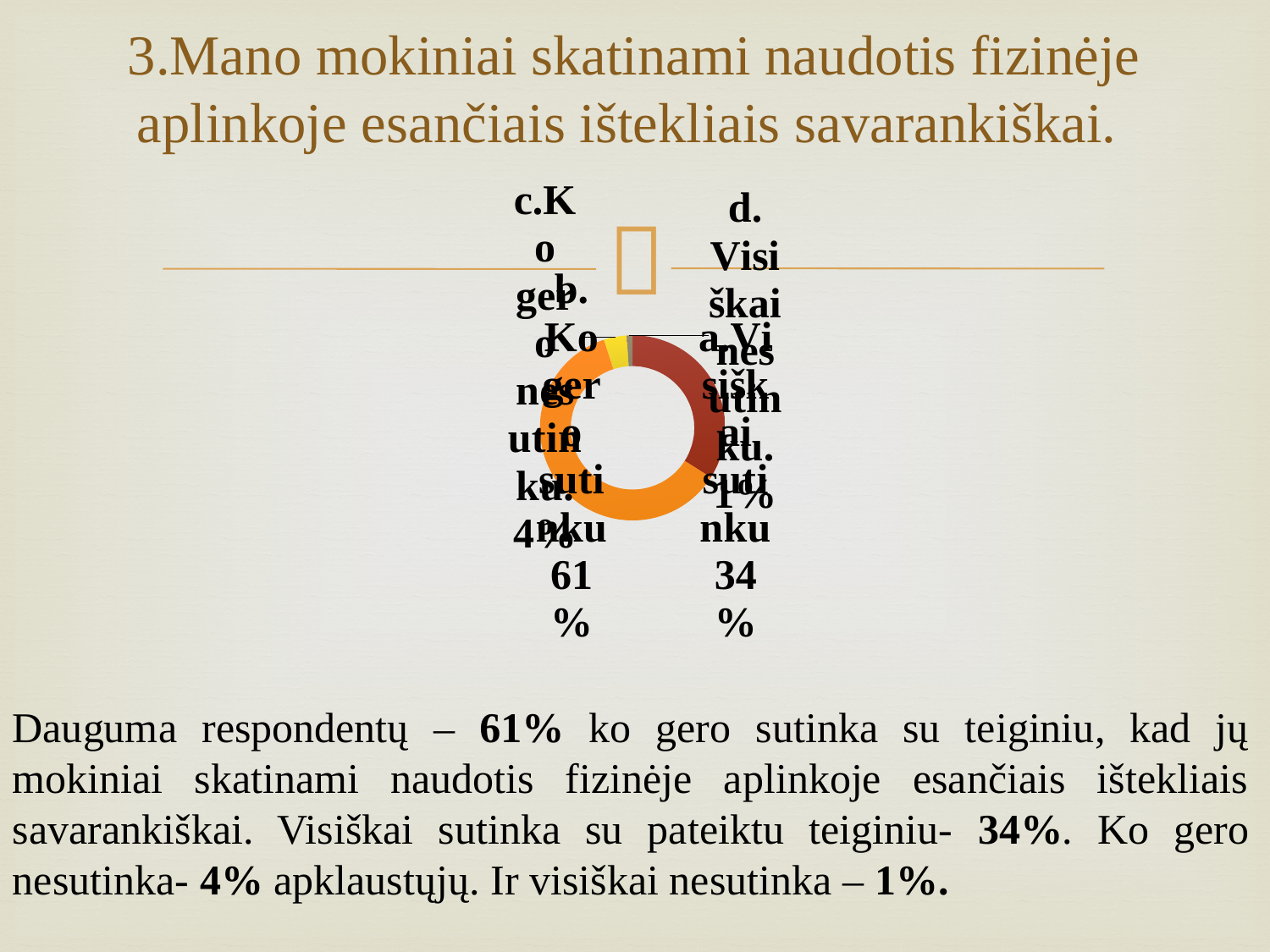
What share of the doughnut chart does "b. Ko gero sutinku" take? 61% What percentage is shown for "a. Visiškai sutinku"? 34% What percentage is shown for "b. Ko gero sutinku"? 61% Which is larger: the share for "c. Ko gero nesutinku" or for "d. Visiškai nesutinku"? c. Ko gero nesutinku What percentage is shown for "c. Ko gero nesutinku"? 4% What colour is the largest slice of the doughnut chart? Orange How many slices does the doughnut chart have? 4 What is the difference in percentage points between "b. Ko gero sutinku" and "a. Visiškai sutinku"? 27 percentage points What kind of chart is shown on the slide? Doughnut (pie) chart Which category has the smallest share of the doughnut chart? d. Visiškai nesutinku What percentage is shown for "d. Visiškai nesutinku"? 1% Which category has the largest share of the doughnut chart? b. Ko gero sutinku